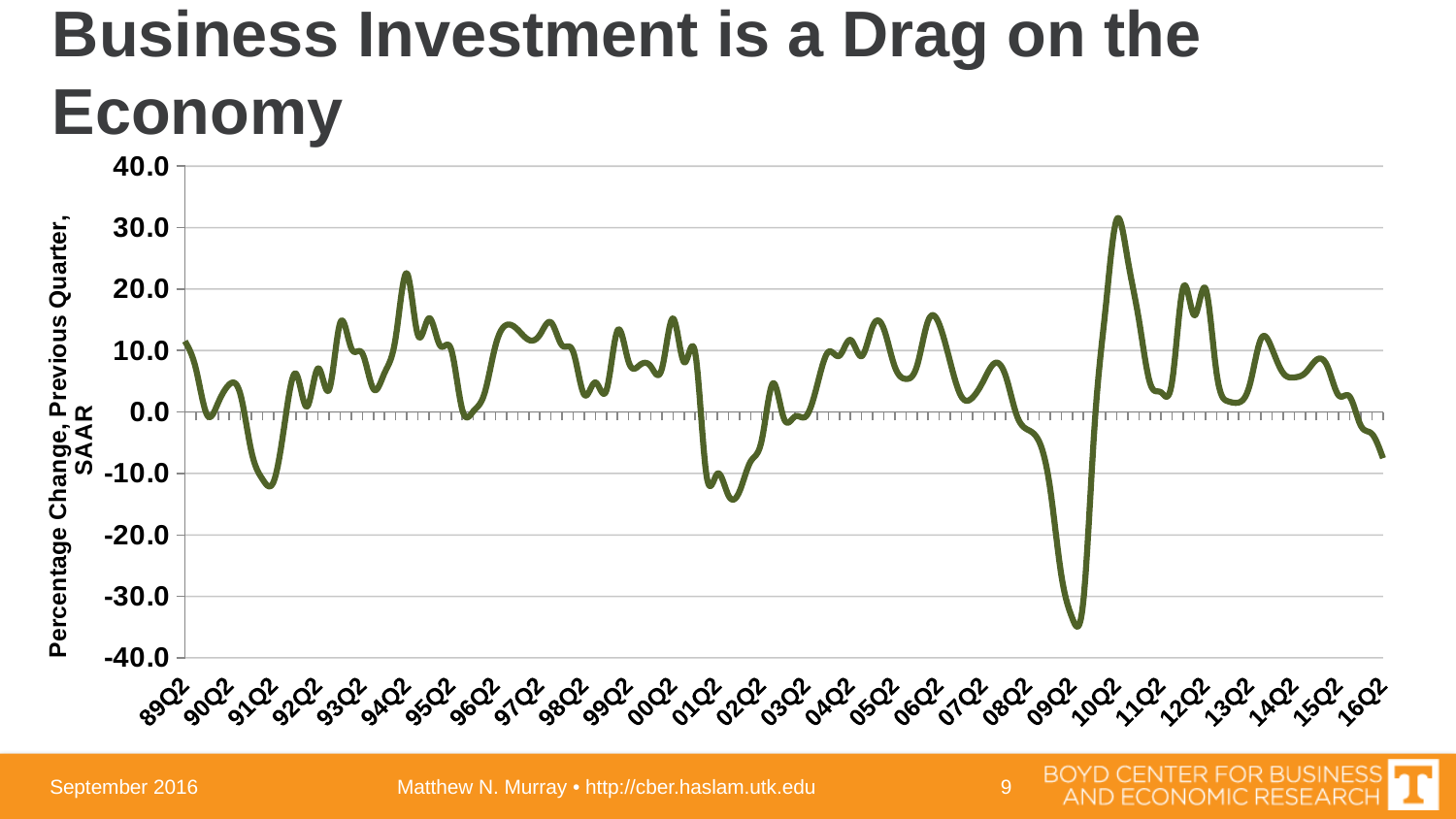
What is the last label on the x axis of the chart? 16Q2 Around which x-axis label does the line reach its lowest value? 09Q2 What kind of chart is shown on the slide? line chart Is the value at 09Q2 greater or less than -30.0? less What is the title of the slide containing the chart? Business Investment is a Drag on the Economy Around which x-axis label does the line reach its highest value? 10Q2 Do the values rise or fall along the x axis from 14Q2 to 16Q2? fall What is the label on the vertical axis of the chart? Percentage Change, Previous Quarter, SAAR Is the value at 16Q2 greater or less than 0.0? less How many labels are shown along the x axis of the chart? 28 Which is larger, the peak near 10Q2 or the peak near 94Q2? the peak near 10Q2 What is the first label on the x axis of the chart? 89Q2